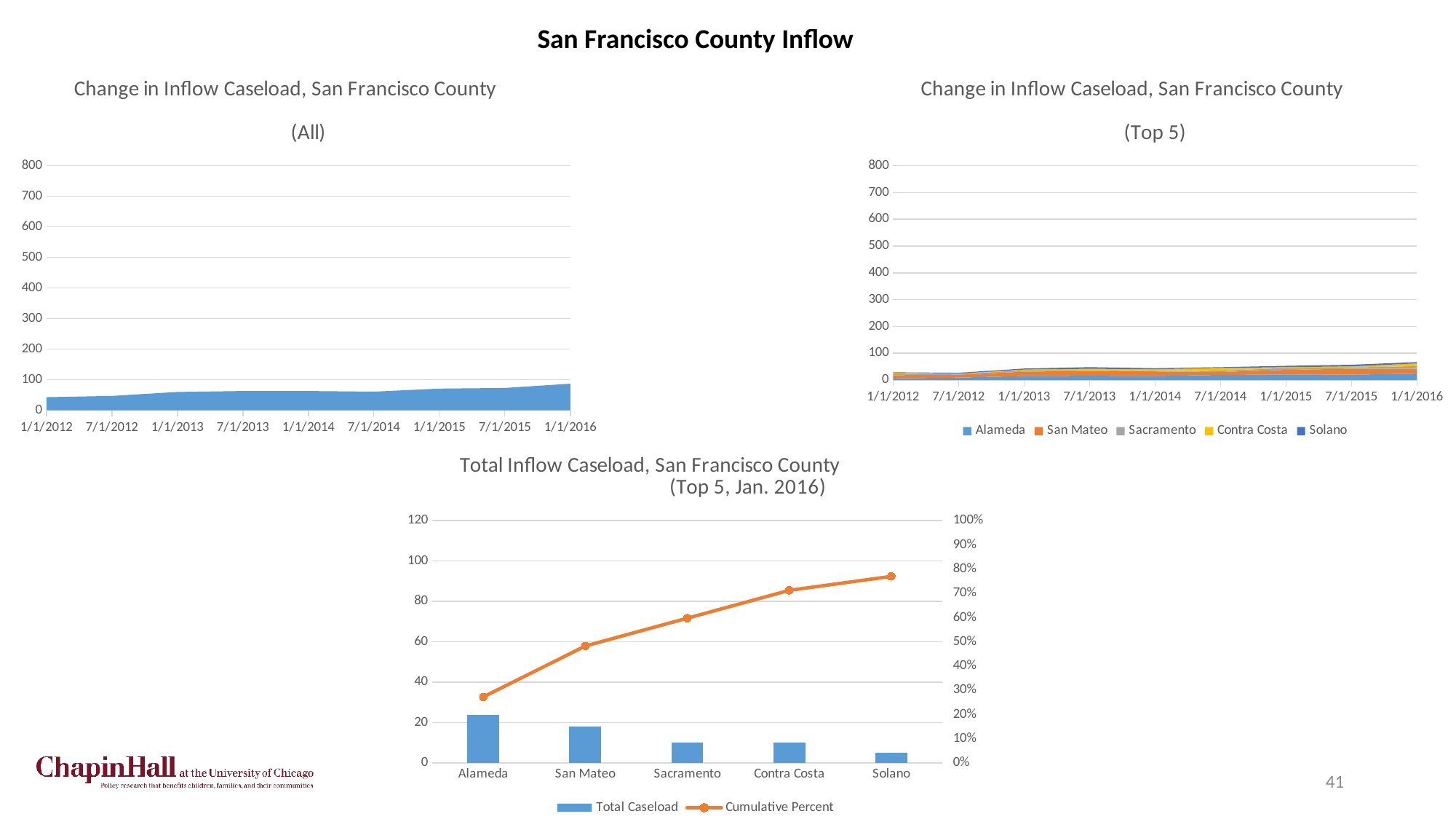
How many series does the legend of the 'Total Inflow Caseload, San Francisco County (Top 5, Jan. 2016)' chart list? 2 In the 'Total Inflow Caseload, San Francisco County (Top 5, Jan. 2016)' chart, is the total caseload for Alameda greater or less than 20? greater How many counties are shown on the x axis of the 'Total Inflow Caseload, San Francisco County (Top 5, Jan. 2016)' chart? 5 In the 'Total Inflow Caseload, San Francisco County (Top 5, Jan. 2016)' chart, is the cumulative percent at Solano greater or less than 70%? greater In the 'Total Inflow Caseload, San Francisco County (Top 5, Jan. 2016)' chart, which county has the lowest total caseload bar? Solano How many series does the legend of the 'Change in Inflow Caseload, San Francisco County (Top 5)' chart list? 5 In the 'Change in Inflow Caseload, San Francisco County (All)' chart, is the value at 1/1/2016 greater or less than 100? less In the 'Change in Inflow Caseload, San Francisco County (All)' chart, does the caseload generally rise or fall from 1/1/2012 to 1/1/2016? rises In the 'Total Inflow Caseload, San Francisco County (Top 5, Jan. 2016)' chart, which county has the highest total caseload bar? Alameda In the 'Total Inflow Caseload, San Francisco County (Top 5, Jan. 2016)' chart, which has a larger total caseload, Alameda or San Mateo? Alameda In the 'Total Inflow Caseload, San Francisco County (Top 5, Jan. 2016)' chart, does the Cumulative Percent line rise or fall from Alameda to Solano? rises